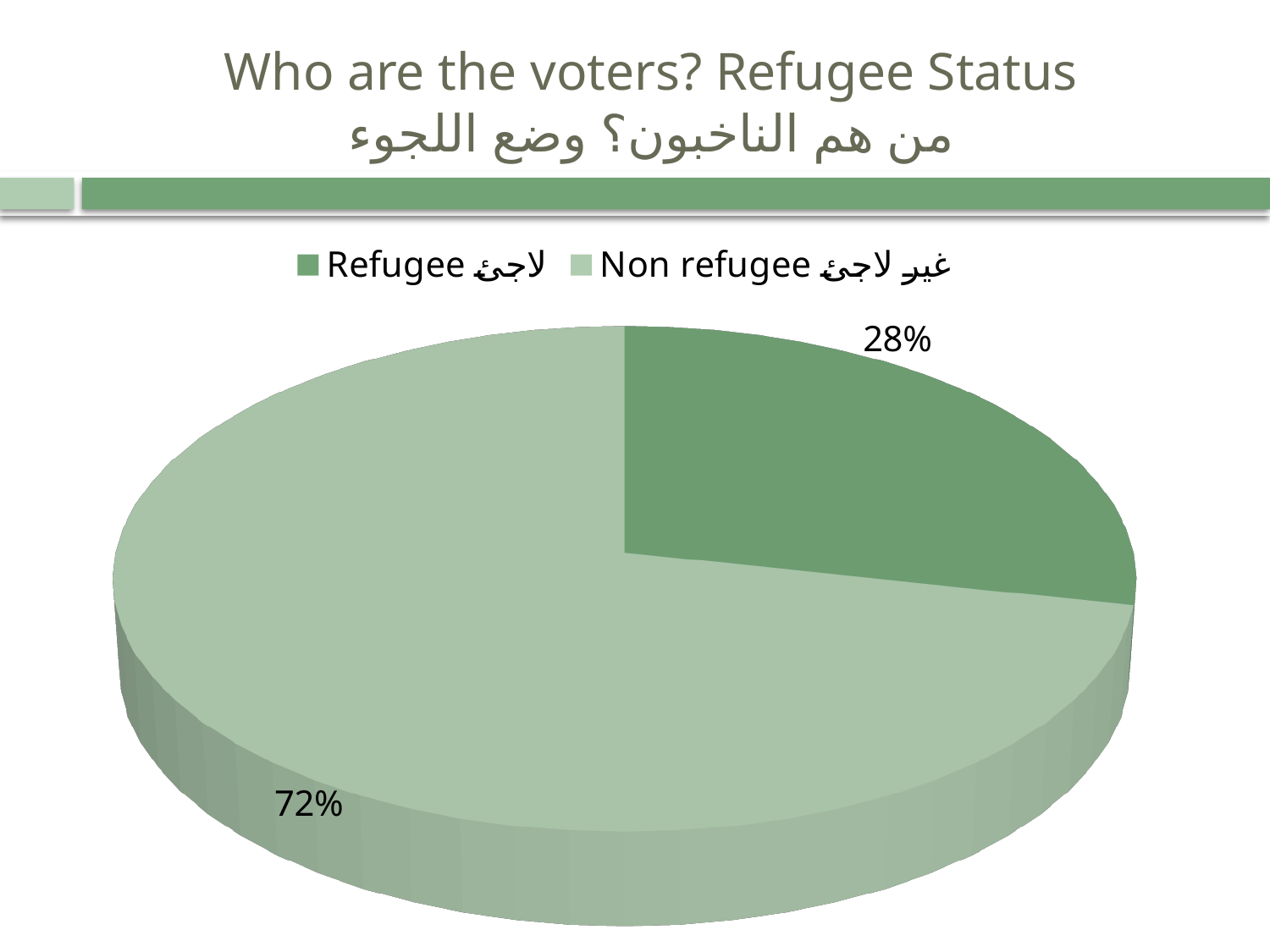
What is the English part of the slide title? Who are the voters? Refugee Status What is the difference in percentage points between the Non refugee and Refugee shares? 44 Which is larger, the Refugee share or the Non refugee share? Non refugee What share of voters are non-refugees? 72% How many slices does the pie chart have? 2 How many entries does the legend list? 2 Which category has the smallest share of the pie? Refugee What share of voters are refugees? 28% What is the share of the pie for the Refugee slice? 28% What kind of chart is shown on the slide? Pie chart Which slice is drawn in the darker green colour? Refugee Which category has the largest share of the pie? Non refugee